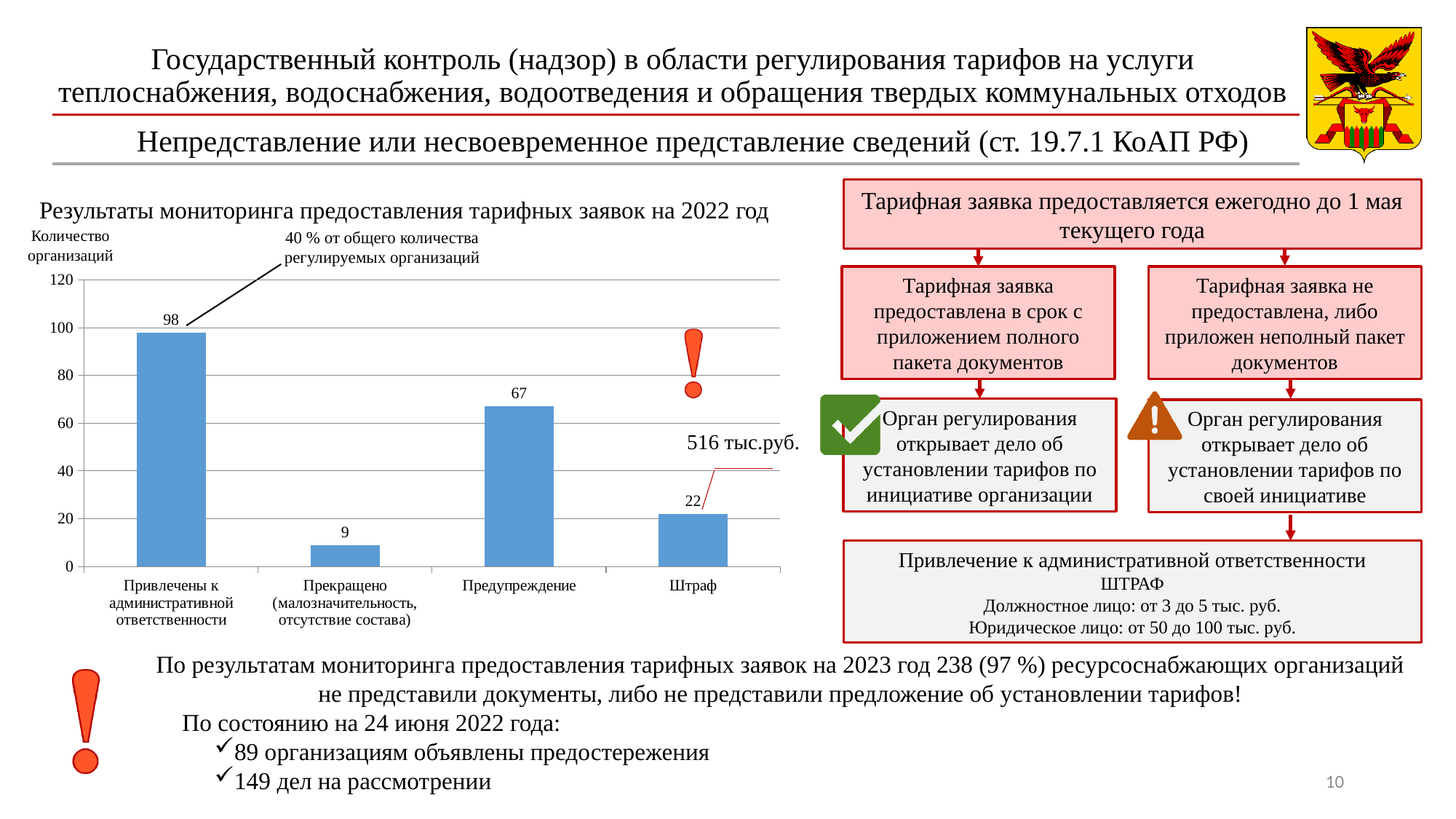
Which is larger, the value for "Предупреждение" or the value for "Штраф"? Предупреждение Which category has the highest value? Привлечены к административной ответственности What amount in thousand rubles is annotated next to the "Штраф" bar? 516 тыс.руб. How many categories are shown on the x axis of the chart? 4 What type of chart is shown on the slide? bar chart Which category has the lowest value? Прекращено (малозначительность, отсутствие состава) What is the value for "Прекращено (малозначительность, отсутствие состава)"? 9 What is the title of the chart? Результаты мониторинга предоставления тарифных заявок на 2022 год What is the value for "Предупреждение"? 67 What is the value for "Привлечены к административной ответственности"? 98 What is the difference between the values for "Предупреждение" and "Штраф"? 45 What is the value for "Штраф"? 22